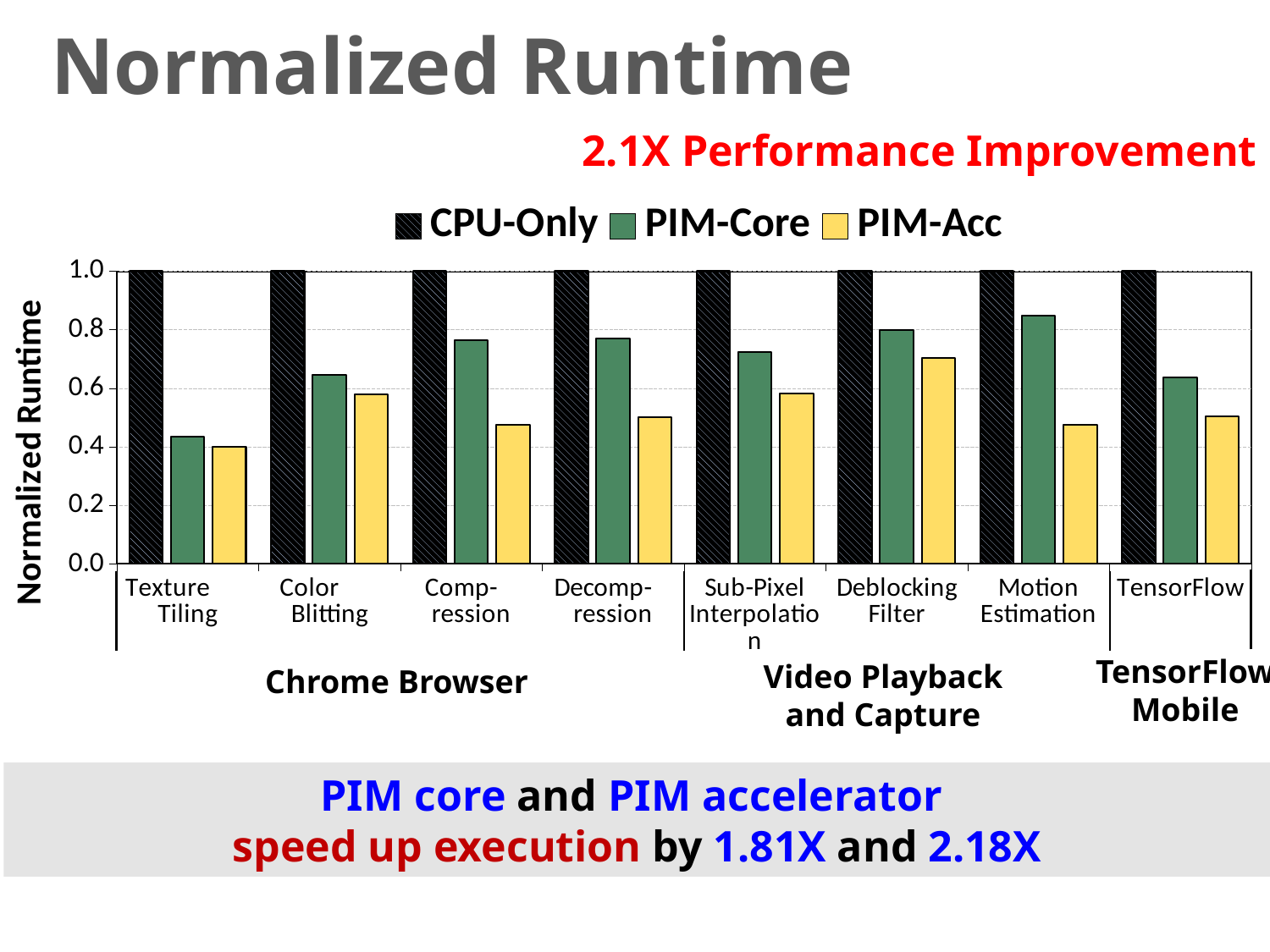
Which category has the highest PIM-Core normalized runtime? Motion Estimation What is the CPU-Only normalized runtime for Texture Tiling? 1.0 What is the label on the y axis? Normalized Runtime Is the PIM-Acc value for Deblocking Filter greater or less than 0.6? greater How many series does the legend list? 3 Which category has the highest PIM-Acc normalized runtime? Deblocking Filter For Compression, which is larger: the PIM-Core value or the PIM-Acc value? PIM-Core Which category has the lowest PIM-Core normalized runtime? Texture Tiling How many workload categories are plotted along the x axis? 8 What is the CPU-Only normalized runtime for TensorFlow? 1.0 What kind of chart is shown on the slide? bar chart Is the PIM-Core value for Texture Tiling greater or less than 0.6? less